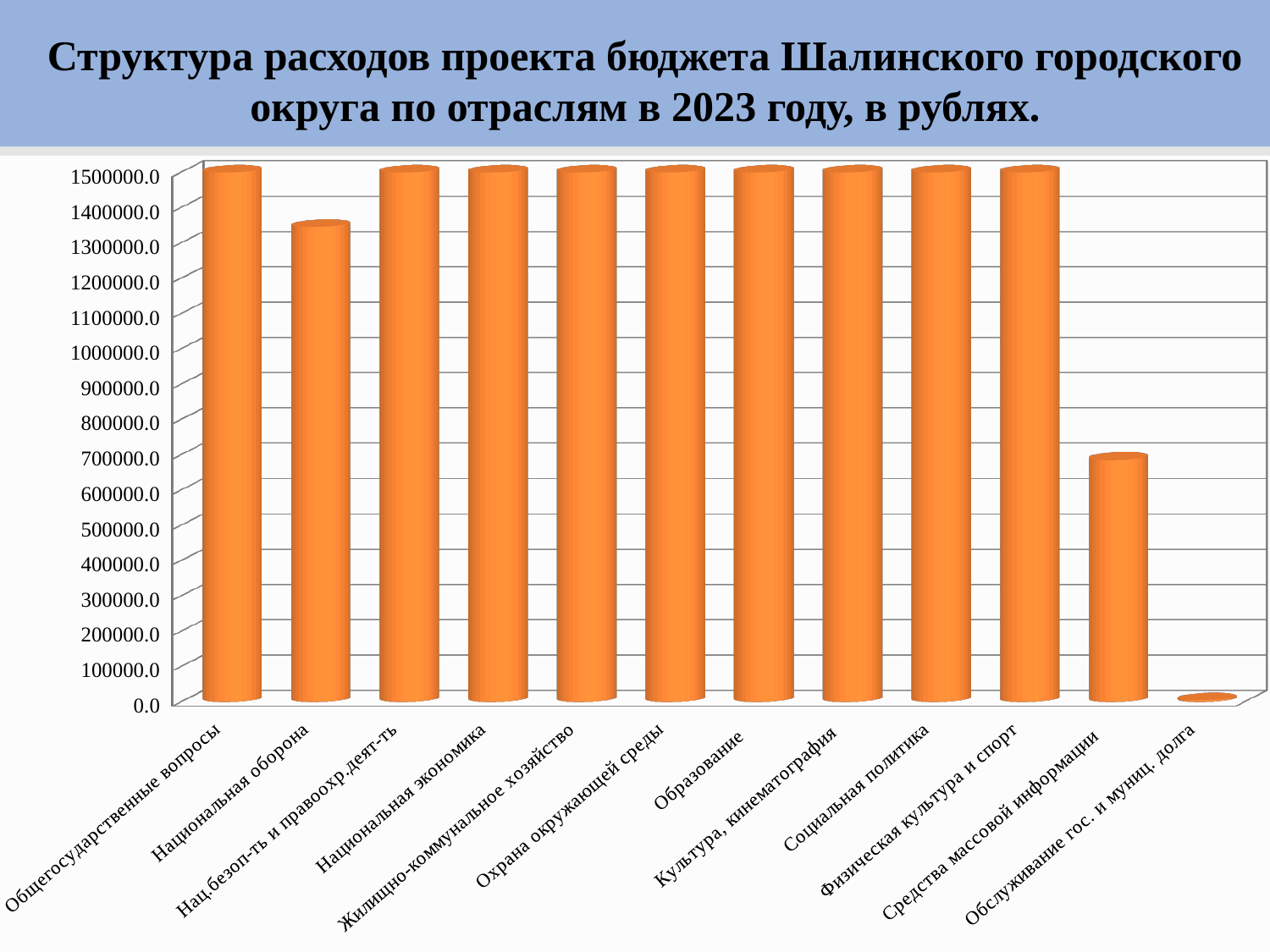
How many categories (sectors) are shown on the x axis of the chart? 12 What kind of chart is shown on the slide? Bar chart What is the highest value shown on the vertical axis of the chart? 1500000.0 Is the value for Национальная оборона greater or less than 1400000.0? less Which category has the lowest value in the chart? Обслуживание гос. и муниц. долга Which is larger: the value for Национальная оборона or the value for Средства массовой информации? Национальная оборона Is the value for Средства массовой информации greater or less than 600000.0? greater Is the value for Обслуживание гос. и муниц. долга greater or less than 100000.0? less What year does the chart title say the budget expenditure structure refers to? 2023 Which is larger: the value for Образование or the value for Средства массовой информации? Образование